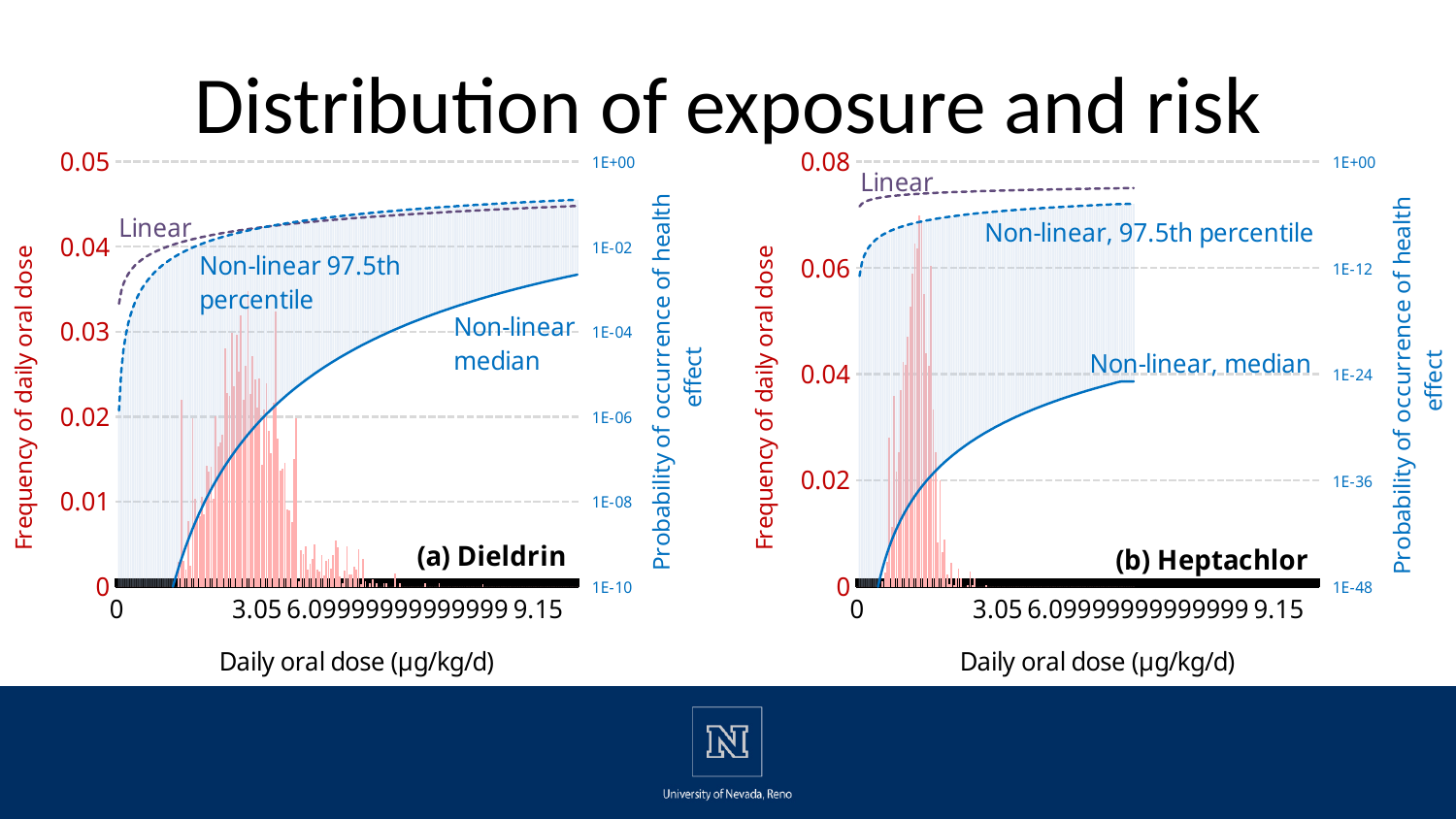
In chart (b) Heptachlor, which curve lies higher, Linear or Non-linear, 97.5th percentile? Linear How many labelled curves are plotted in chart (b) Heptachlor? 3 What kind of chart is (a) Dieldrin? a combined bar and line chart In chart (b) Heptachlor, does the Non-linear, median curve rise or fall as daily oral dose increases? rise What is the x-axis label shared by both charts? Daily oral dose (µg/kg/d) In chart (b) Heptachlor, is the tallest red histogram bar greater or less than 0.04 on the left axis? greater In chart (a) Dieldrin, which curve lies higher, Linear or Non-linear median? Linear In chart (a) Dieldrin, does the Non-linear median curve rise or fall as daily oral dose increases? rise What is the title of the slide? Distribution of exposure and risk In chart (a) Dieldrin, is the tallest red histogram bar greater or less than 0.02 on the left axis? greater How many charts are shown on the slide? 2